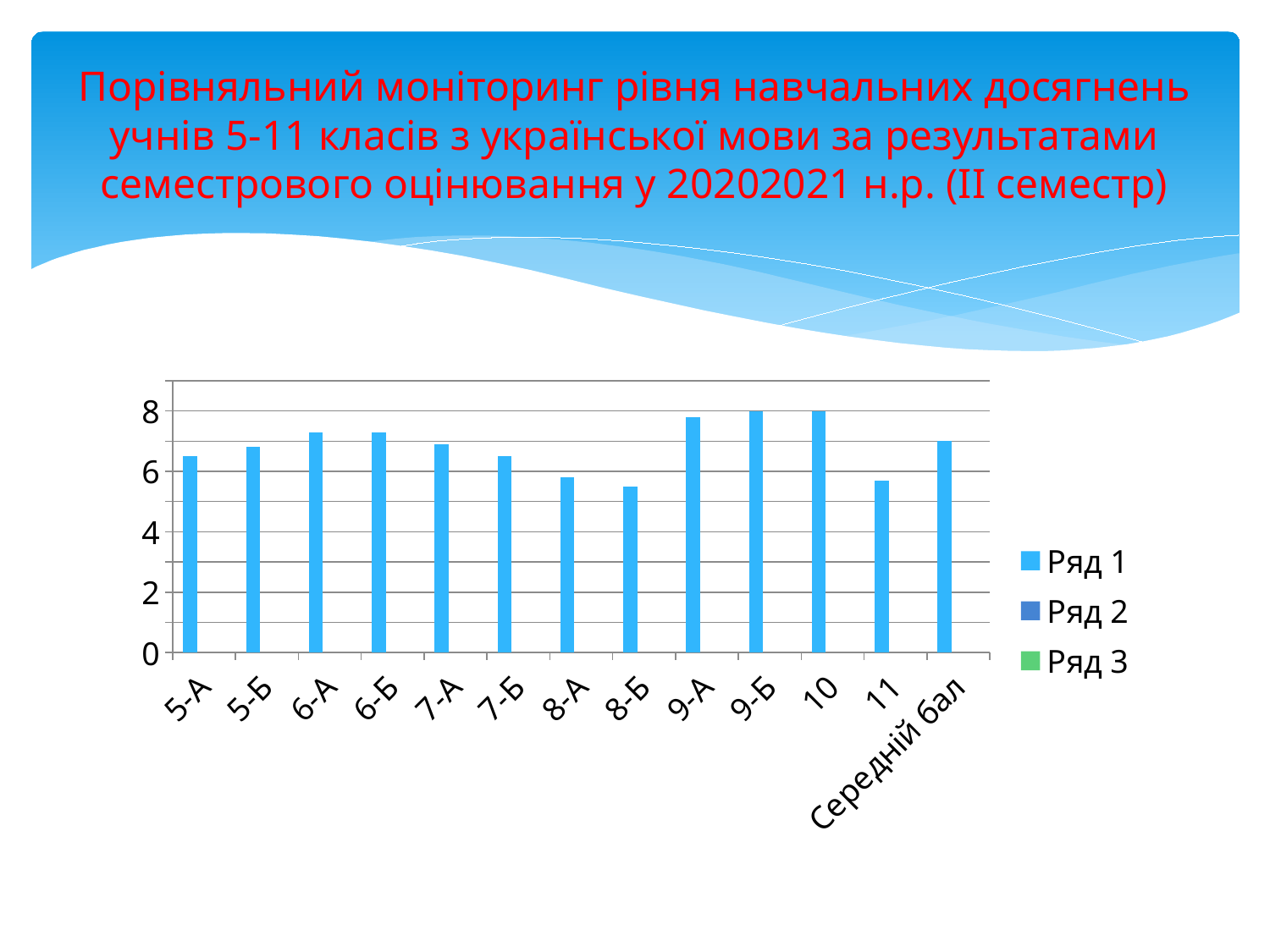
How many categories are shown along the x axis of the chart? 13 Is the value for 6-А greater or less than 6? greater Which has the larger value, 10 or 11? 10 Is the value for 9-Б greater or less than 4? greater What kind of chart is shown on the slide? bar chart Is the value for 11 greater or less than 6? less Which has the larger value, 9-А or 8-Б? 9-А How many series does the chart's legend list? 3 Which has the larger value, 6-А or 5-А? 6-А What is the label of the first series in the chart's legend? Ряд 1